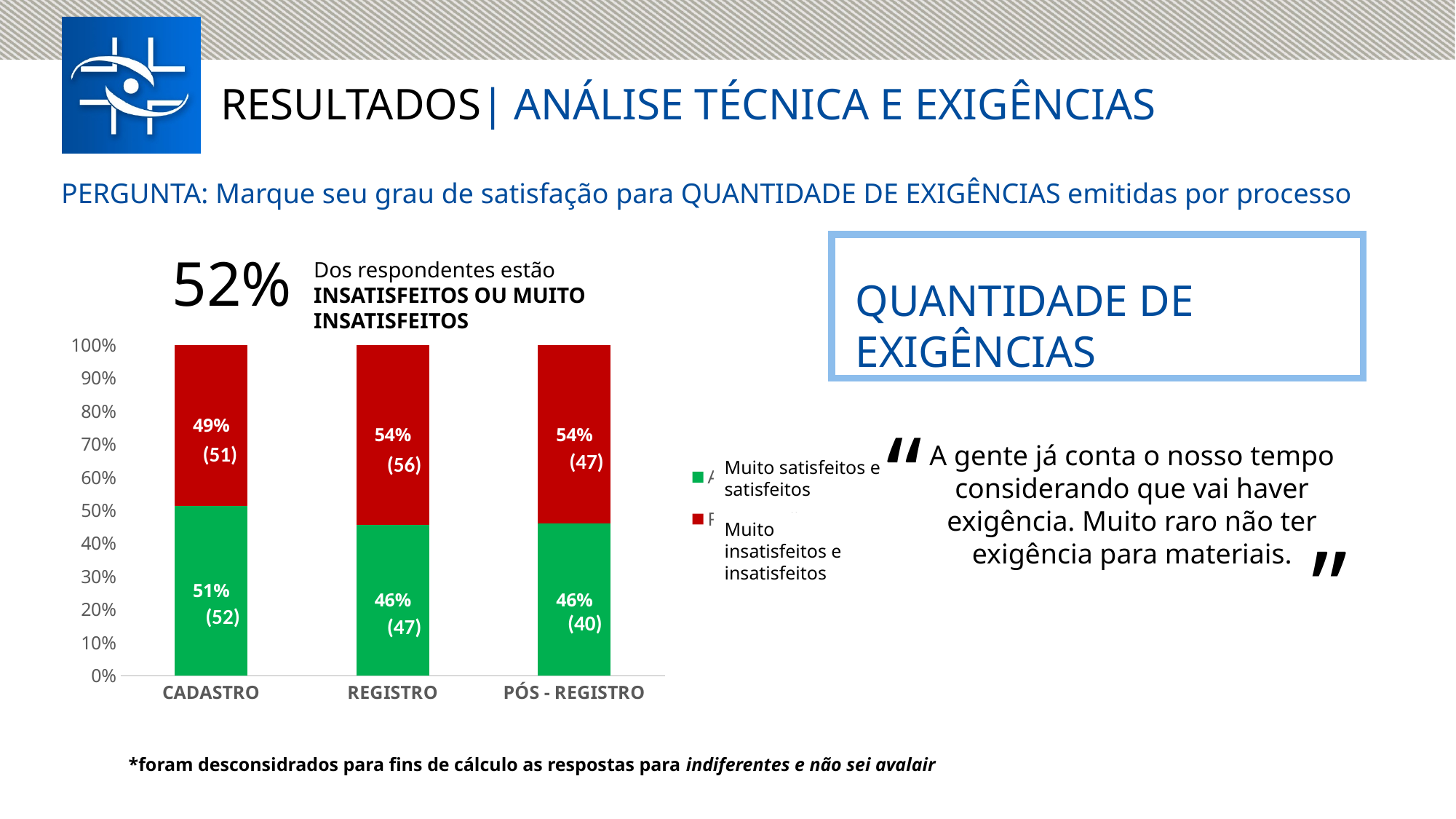
How many categories are shown on the x axis of the chart? 3 What is the count shown in parentheses for the 'Muito satisfeitos e satisfeitos' segment of PÓS - REGISTRO? 40 For CADASTRO, which segment is larger: 'Muito satisfeitos e satisfeitos' or 'Muito insatisfeitos e insatisfeitos'? Muito satisfeitos e satisfeitos What kind of chart is shown on the slide? Stacked bar chart What is the total of the two segments in the REGISTRO bar? 100% How many series does the chart's legend list? 2 Which category has the highest percentage of 'Muito satisfeitos e satisfeitos' respondents? CADASTRO What percentage of respondents for CADASTRO are 'Muito satisfeitos e satisfeitos'? 51% Which colour represents the 'Muito insatisfeitos e insatisfeitos' series in the chart? Red What is the count shown in parentheses for the 'Muito insatisfeitos e insatisfeitos' segment of CADASTRO? 51 What is the difference in percentage points between the 'Muito insatisfeitos e insatisfeitos' and 'Muito satisfeitos e satisfeitos' segments for REGISTRO? 8 What percentage of respondents for REGISTRO are 'Muito insatisfeitos e insatisfeitos'? 54%